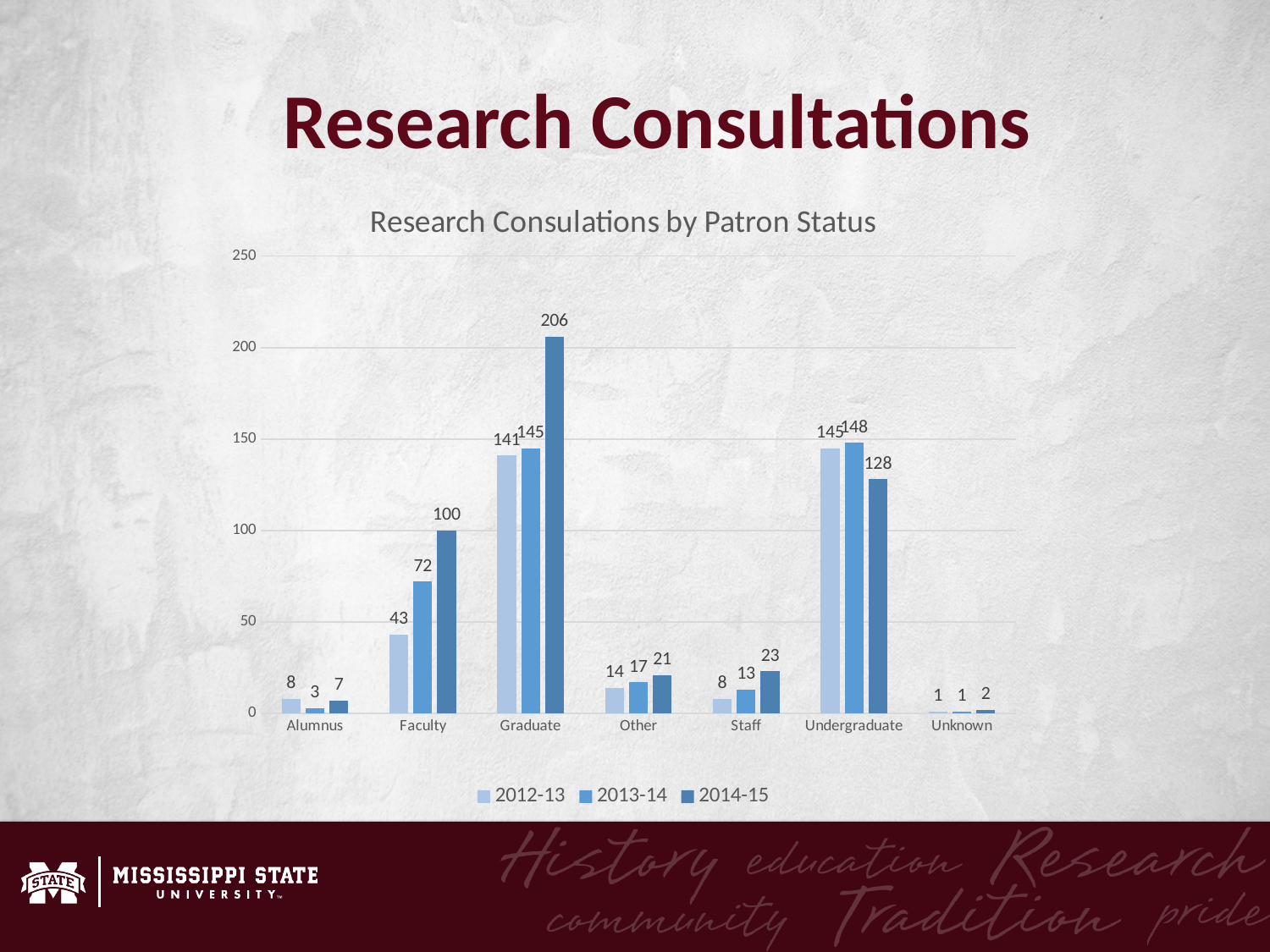
Which is larger for Undergraduate: the 2013-14 value or the 2014-15 value? 2013-14 What is the value for Graduate in 2014-15? 206 How many patron status categories are shown on the x axis? 7 Which patron status has the highest value in 2014-15? Graduate Which patron status has the lowest value in 2013-14? Unknown What is the value for Undergraduate in 2012-13? 145 What kind of chart is shown on the slide? bar chart What is the value for Faculty in 2013-14? 72 What is the title of the chart? Research Consulations by Patron Status How many series does the legend list? 3 What is the difference between the 2014-15 and 2013-14 values for Graduate? 61 Is the value for Faculty in 2012-13 greater or less than 50? less